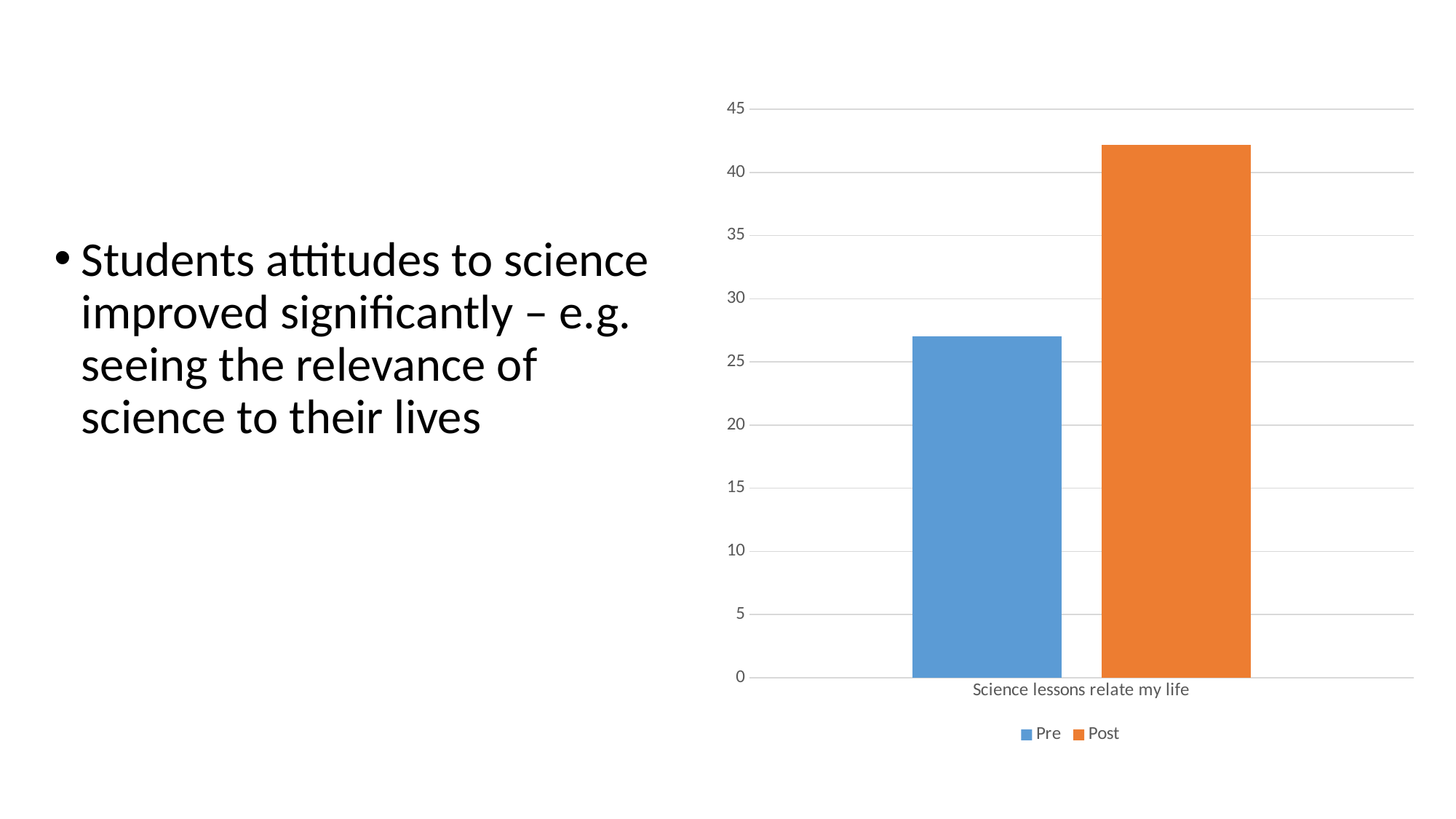
What is the category label on the x axis? Science lessons relate my life How many series does the legend list? 2 What are the series names listed in the legend? Pre, Post Which series has the lowest bar in the chart? Pre Is the Pre value for 'Science lessons relate my life' greater or less than 25? greater Which series has the higher value for 'Science lessons relate my life', Pre or Post? Post Is the Post value for 'Science lessons relate my life' greater or less than 45? less Is the Pre value for 'Science lessons relate my life' greater or less than 30? less Which series has the highest bar in the chart? Post How many categories are shown on the x axis? 1 What kind of chart is shown on the slide? bar chart